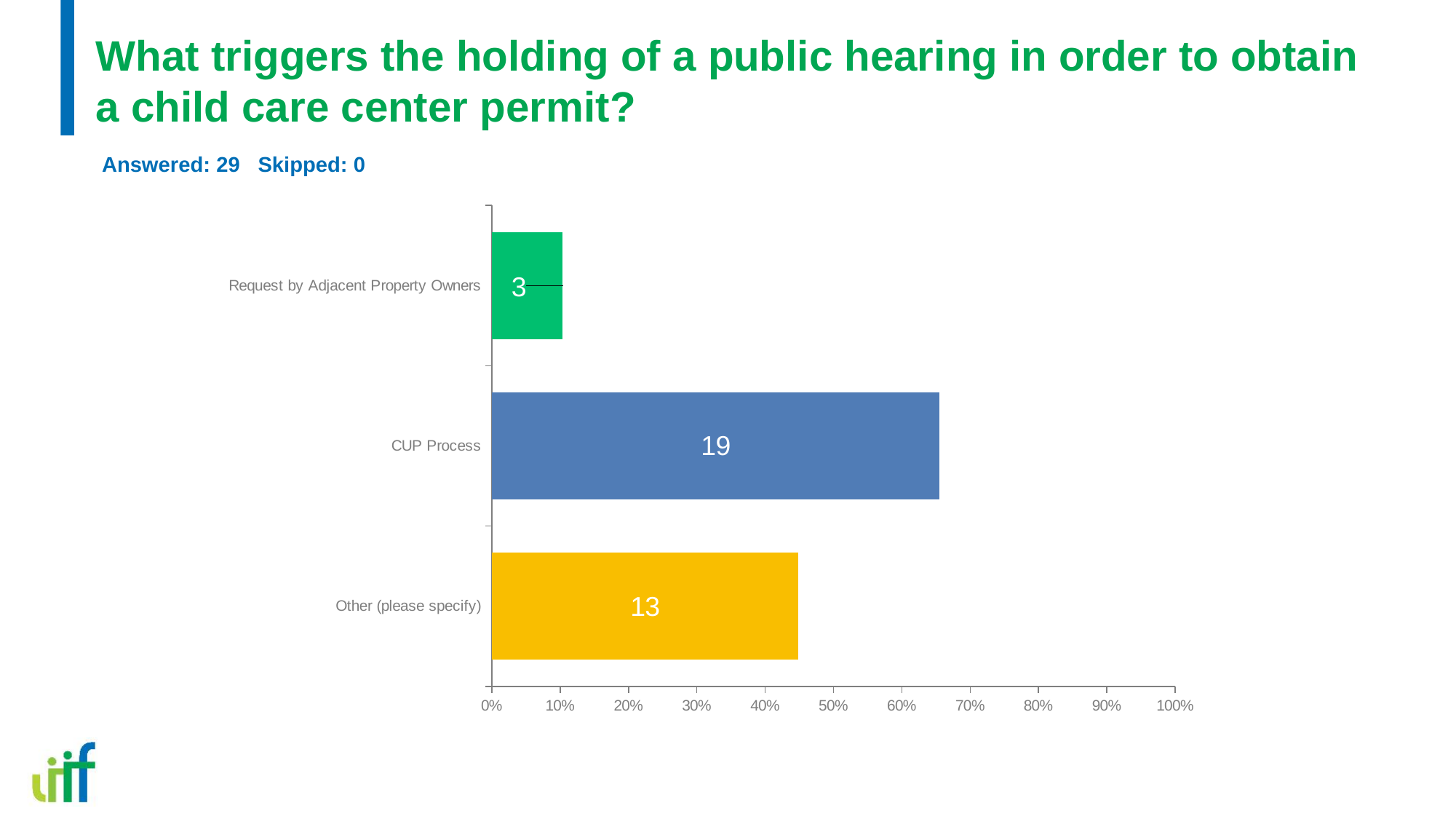
What is the difference between the data labels for CUP Process and Other (please specify)? 6 Which category has the shortest bar? Request by Adjacent Property Owners What is the data label on the bar for Request by Adjacent Property Owners? 3 What is the data label on the bar for Other (please specify)? 13 How many categories are shown in the chart? 3 What is the data label on the bar for CUP Process? 19 What kind of chart is shown on the slide? Bar chart Is the bar for CUP Process greater or less than 60% on the axis? greater Which category has the longest bar? CUP Process How many respondents answered the question according to the slide? 29 Is the bar for Other (please specify) greater or less than 50% on the axis? less Which is larger, the value for Other (please specify) or the value for Request by Adjacent Property Owners? Other (please specify)